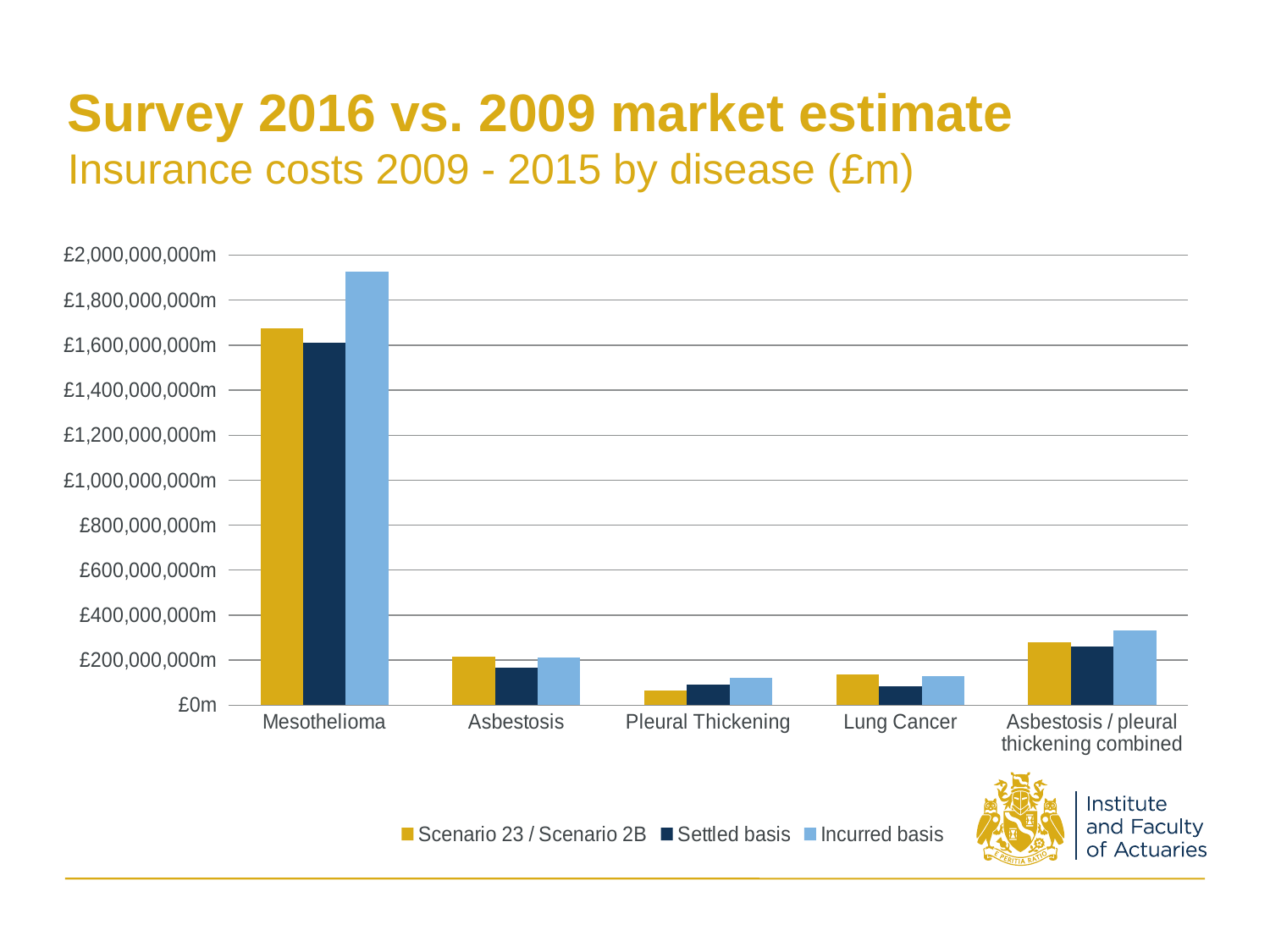
What kind of chart is shown on the slide? bar chart How many series does the legend list? 3 Is the Incurred basis value for Mesothelioma greater or less than £1,800,000,000m? greater Is the Settled basis value for Lung Cancer greater or less than £200,000,000m? less For Mesothelioma, which is larger: the Settled basis value or the Incurred basis value? Incurred basis Which disease category has the lowest Scenario 23 / Scenario 2B value? Pleural Thickening How many disease categories are shown on the x axis? 5 Which series is shown in light blue in the legend? Incurred basis Is the Incurred basis value for Asbestosis / pleural thickening combined greater or less than £200,000,000m? greater For Pleural Thickening, which is larger: the Scenario 23 / Scenario 2B value or the Incurred basis value? Incurred basis Which disease category has the highest Incurred basis value? Mesothelioma